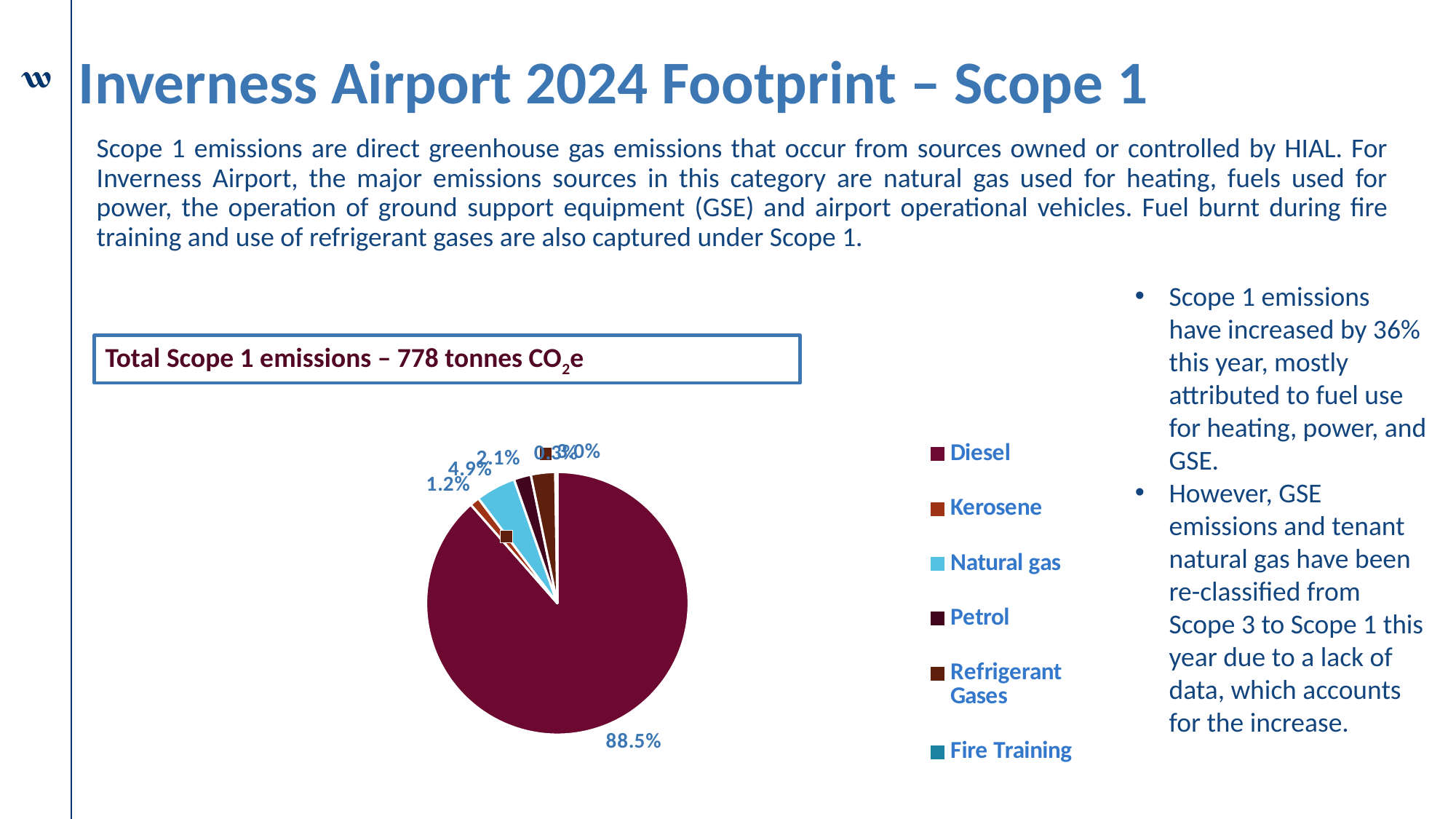
What percentage of the pie chart is Petrol? 2.1% What percentage of the pie chart is Natural gas? 4.9% Which category has the smallest slice of the pie chart? Fire Training Which category has the largest slice of the pie chart? Diesel What percentage of the pie chart is Kerosene? 1.2% What is the difference in percentage points between the Natural gas and Petrol slices? 2.8% According to the boxed text above the chart, what are the total Scope 1 emissions? 778 tonnes CO2e Which is larger in the pie chart, Natural gas or Petrol? Natural gas What type of chart is shown on the slide? Pie chart What is the difference in percentage points between the Diesel and Natural gas slices? 83.6% What share of Scope 1 emissions does Diesel account for in the pie chart? 88.5% How many categories are listed in the pie chart's legend? 6